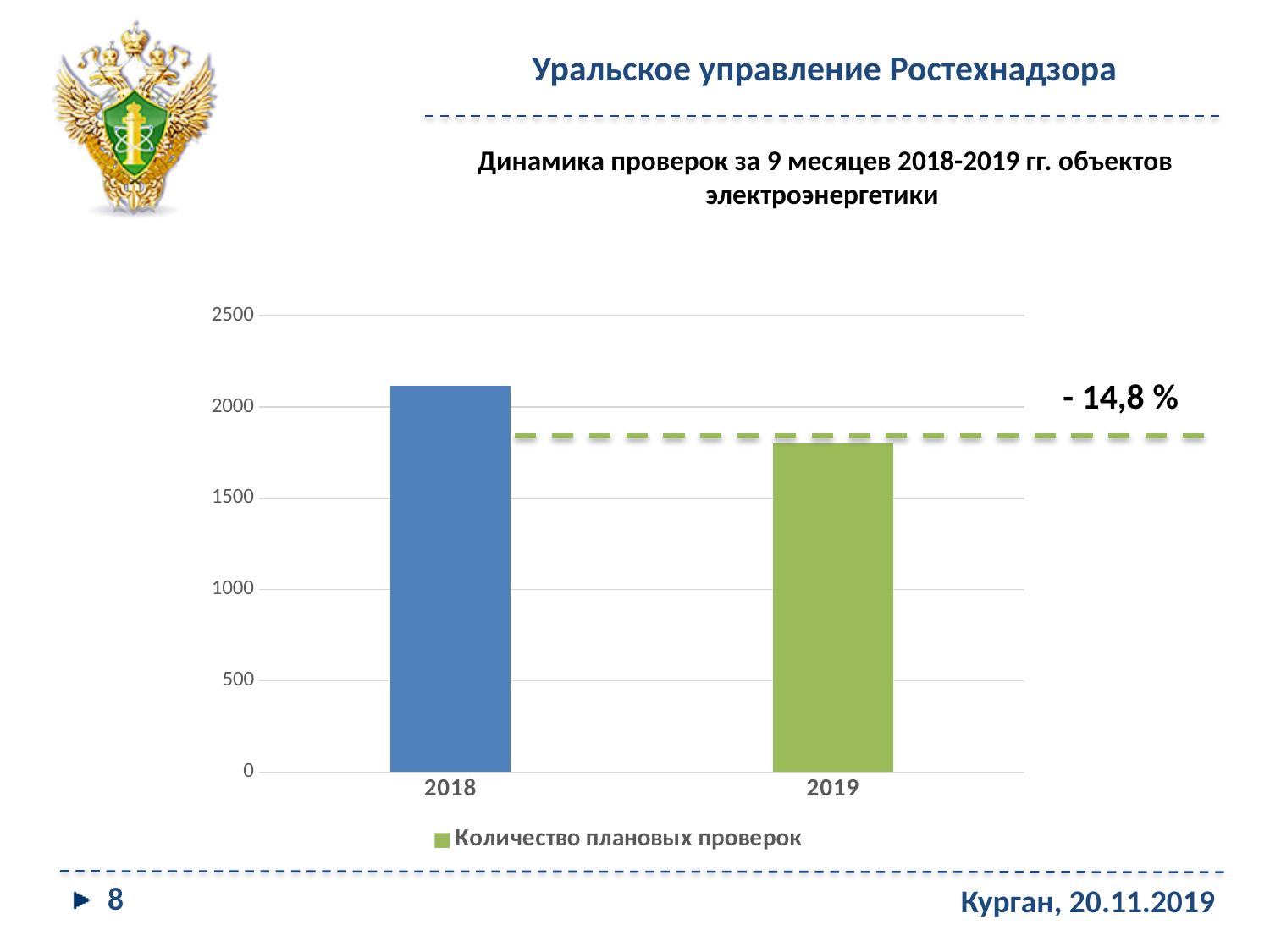
What percentage change is annotated next to the dashed line on the chart? - 14,8 % Is the value for 2019 greater or less than 2000? less How many categories (years) are plotted on the chart? 2 How many series does the chart legend list? 1 Which year has the lower number of planned inspections? 2019 What kind of chart is shown on the slide? bar chart Do the values rise or fall from 2018 to 2019? fall Is the value for 2018 greater or less than 2000? greater Which is larger: the value for 2018 or the value for 2019? 2018 Which year has the higher number of planned inspections? 2018 What series name is shown in the chart legend? Количество плановых проверок Is the value for 2019 greater or less than 1500? greater